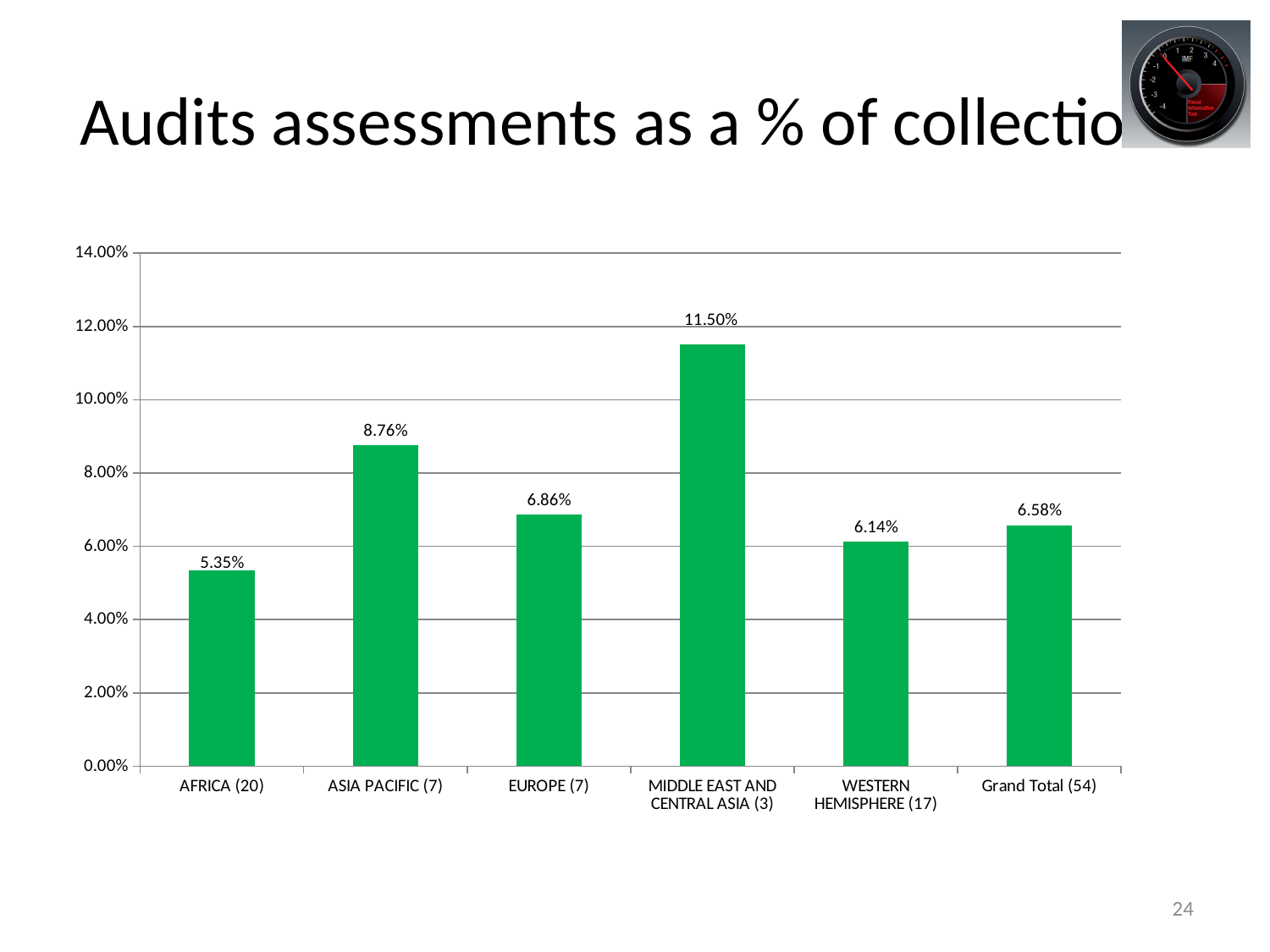
Which category has the lowest value? AFRICA (20) What is the value for MIDDLE EAST AND CENTRAL ASIA (3)? 11.50% Which category has the highest value? MIDDLE EAST AND CENTRAL ASIA (3) Is the value for ASIA PACIFIC (7) greater or less than 8.00%? greater What is the value for AFRICA (20)? 5.35% What is the value for Grand Total (54)? 6.58% What is the difference between the values for ASIA PACIFIC (7) and EUROPE (7)? 1.90% What colour are the bars in the chart? green What kind of chart is shown on the slide? bar chart Which is larger, the value for EUROPE (7) or the value for WESTERN HEMISPHERE (17)? EUROPE (7) What is the value for WESTERN HEMISPHERE (17)? 6.14% How many categories are shown on the x axis? 6